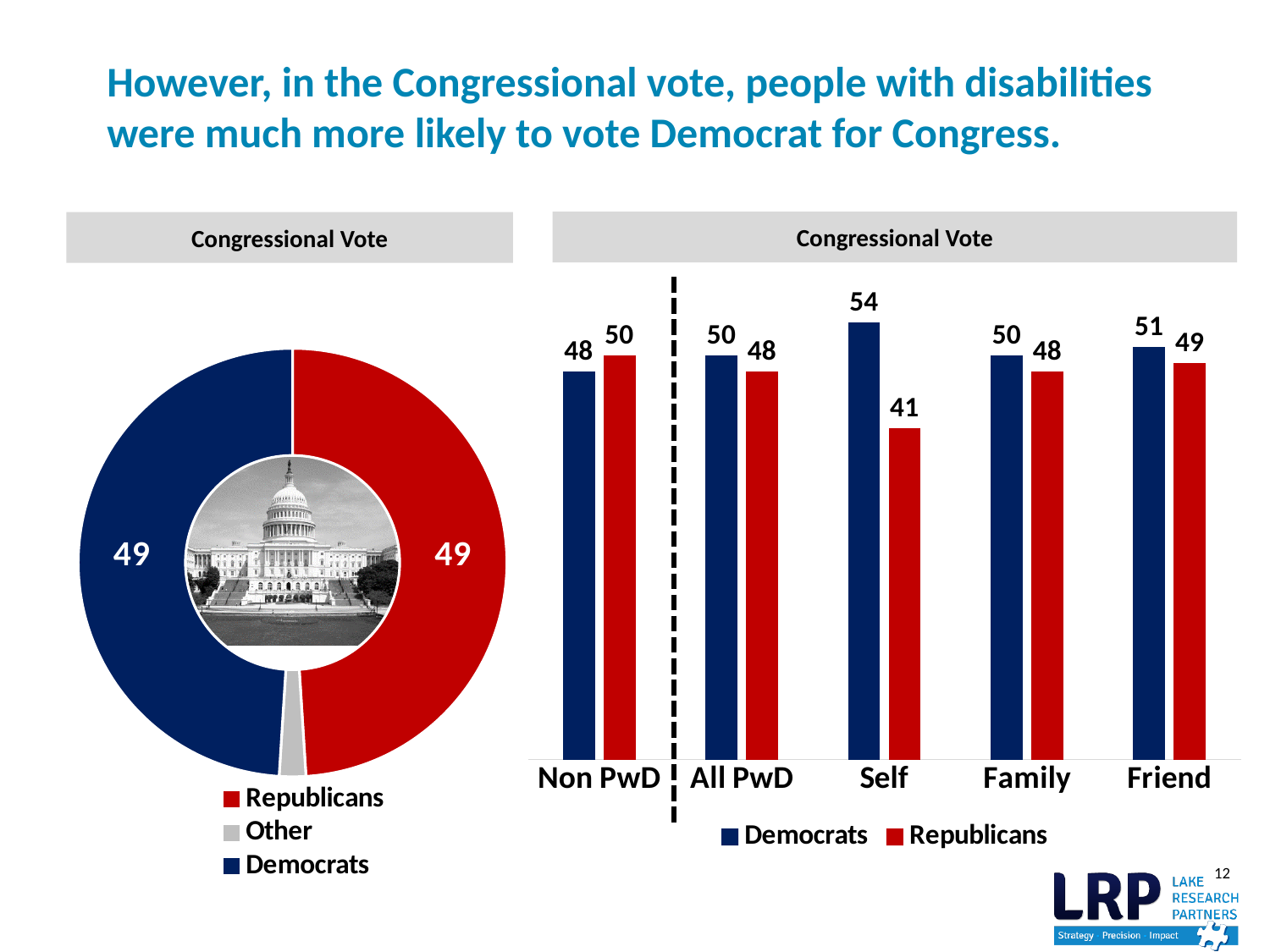
In the bar chart on the right, what is the difference between the Democrats and Republicans values in the Self category? 13 How many entries does the legend of the pie chart on the left list? 3 What kind of chart is the chart on the right of the slide? bar chart In the bar chart on the right, what is the value for Republicans in the Friend category? 49 In the bar chart on the right, which is larger in the Non PwD category, Democrats or Republicans? Republicans In the bar chart on the right, what is the value for Republicans in the Non PwD category? 50 In the bar chart on the right, which category has the highest Democrats value? Self In the pie chart on the left, what is the value shown for Republicans? 49 In the bar chart on the right, which category has the lowest Republicans value? Self How many categories are shown on the x axis of the bar chart on the right? 5 In the bar chart on the right, what is the value for Democrats in the Self category? 54 How many series does the legend of the bar chart on the right list? 2